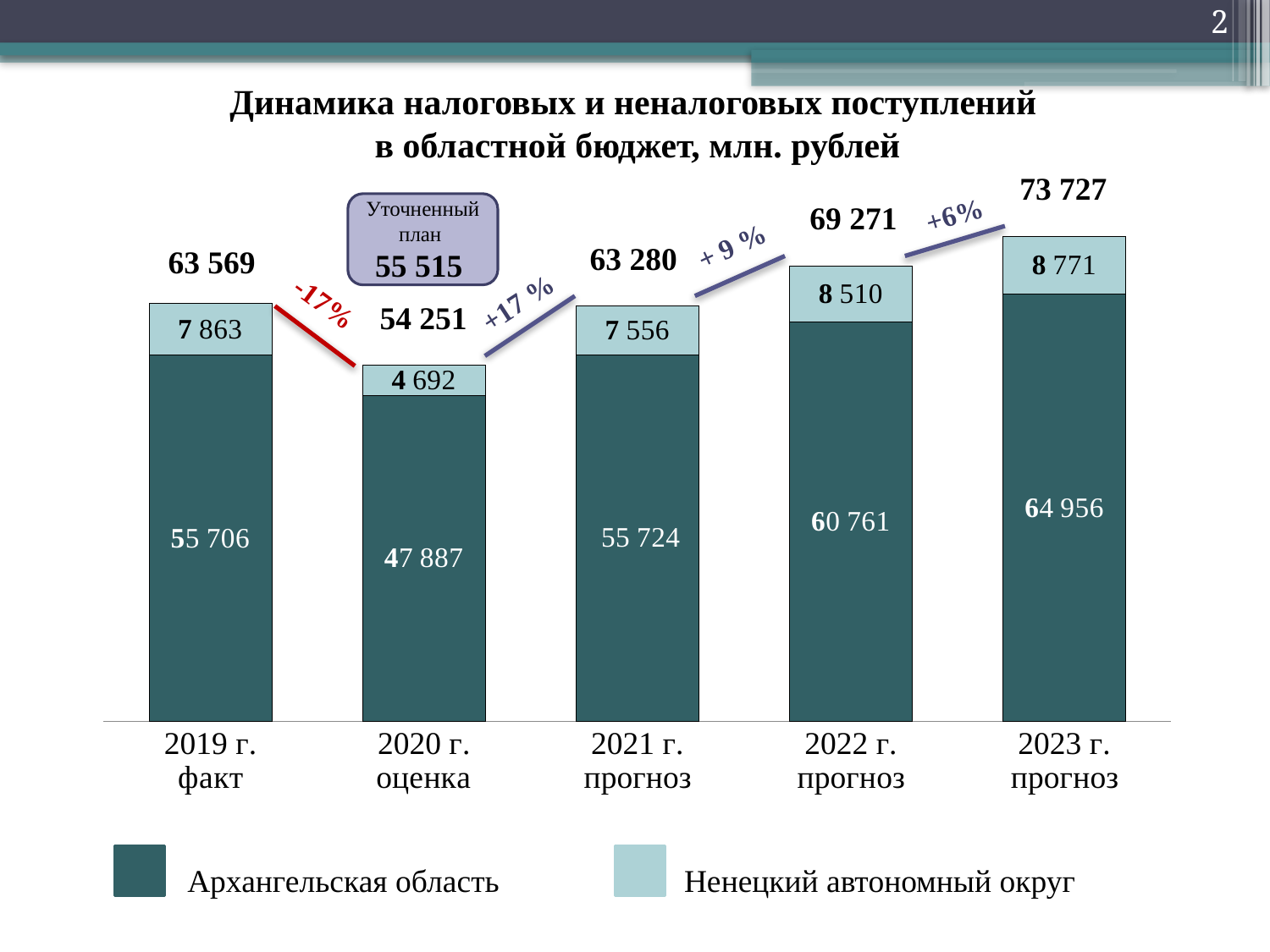
What is the value for Архангельская область in 2023 г. прогноз? 64 956 Which year has the highest value for Ненецкий автономный округ? 2023 г. прогноз What is the value for Архангельская область in 2019 г. факт? 55 706 What is the difference between the Архангельская область values for 2022 г. прогноз and 2021 г. прогноз? 5 037 How many years (categories) are shown on the x axis? 5 What kind of chart is shown on the slide? Stacked bar chart Which is larger: the Ненецкий автономный округ value in 2019 г. факт or in 2021 г. прогноз? 2019 г. факт What is the total of the stacked bar for 2022 г. прогноз? 69 271 What percentage change is shown between 2022 г. прогноз and 2023 г. прогноз? +6% How many series does the legend list? 2 Which year has the lowest total of the stacked bar? 2020 г. оценка What is the value for Ненецкий автономный округ in 2020 г. оценка? 4 692